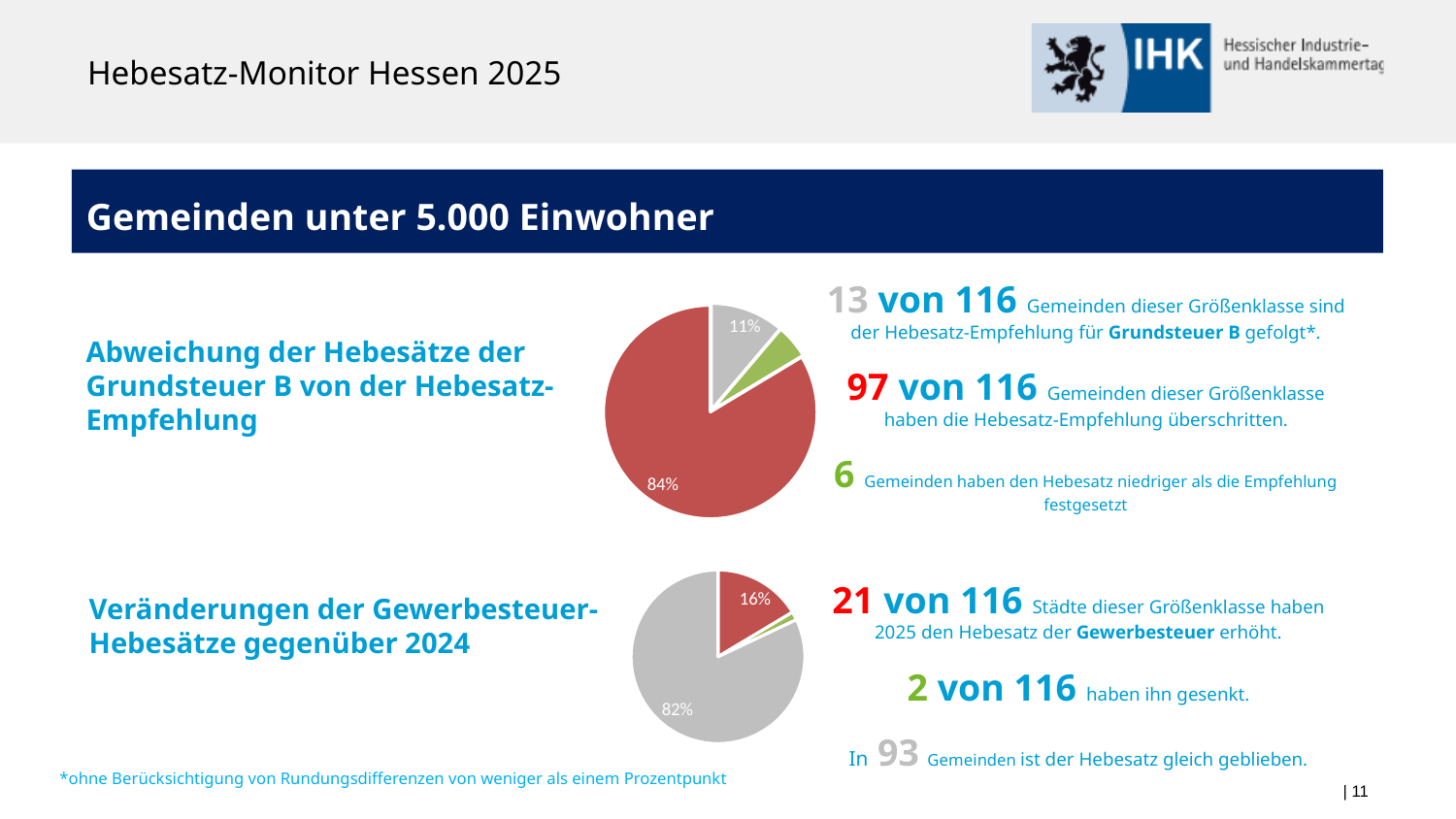
In the bottom pie chart (Gewerbesteuer-Hebesätze gegenüber 2024), what percentage is shown on the red slice? 16% In the top pie chart (Grundsteuer B), what colour is the smallest slice? Green Which is larger: the red slice of the top pie chart (Grundsteuer B) or the red slice of the bottom pie chart (Gewerbesteuer)? The red slice of the top pie chart (84%) How many slices does the bottom pie chart (Gewerbesteuer-Hebesätze gegenüber 2024) have? 3 What kind of chart is used under the heading 'Abweichung der Hebesätze der Grundsteuer B von der Hebesatz-Empfehlung'? Pie chart In the top pie chart (Grundsteuer B), what colour is the largest slice? Red How many slices does the top pie chart (Grundsteuer B) have? 3 In the bottom pie chart (Gewerbesteuer-Hebesätze gegenüber 2024), what colour is the largest slice? Grey In the top pie chart (Grundsteuer B), what percentage is shown on the grey slice? 11% In the top pie chart (Grundsteuer B), what percentage is shown on the largest slice? 84% In the bottom pie chart (Gewerbesteuer-Hebesätze gegenüber 2024), what percentage is shown on the largest slice? 82% What is the difference in percentage points between the two labelled slices of the top pie chart (84% and 11%)? 73 percentage points